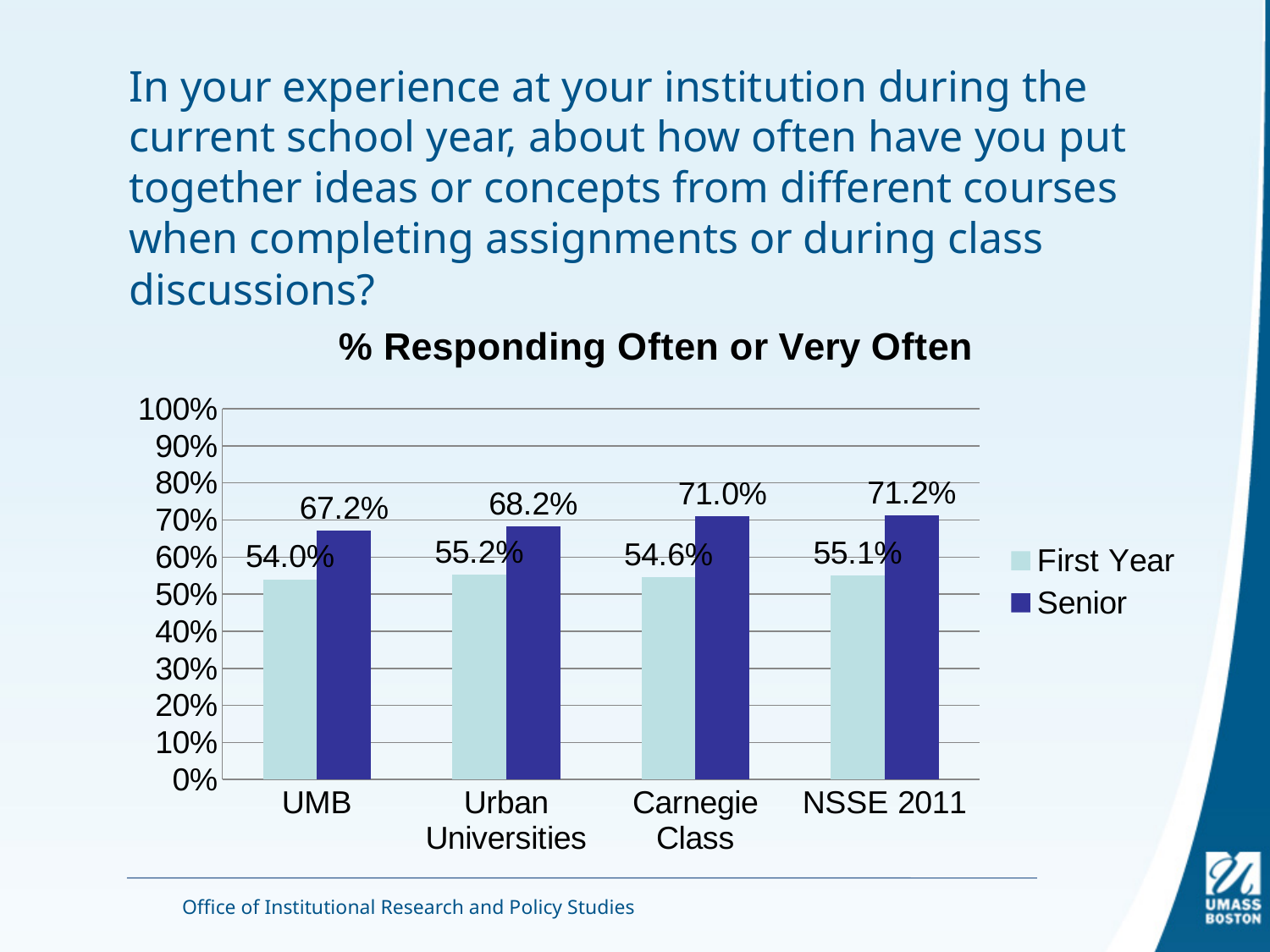
Is the Senior value for NSSE 2011 greater or less than 70%? greater What kind of chart is shown on the slide? Bar chart Which is larger, the Senior value for Carnegie Class or the Senior value for Urban Universities? Carnegie Class What is the First Year value for Carnegie Class? 54.6% Which category has the lowest Senior value? UMB How many series does the legend list? 2 What is the First Year value for UMB? 54.0% What is the Senior value for Urban Universities? 68.2% What is the difference between the Senior and First Year values for UMB? 13.2% What is the Senior value for NSSE 2011? 71.2% How many categories are shown on the x axis? 4 Which category has the highest First Year value? Urban Universities